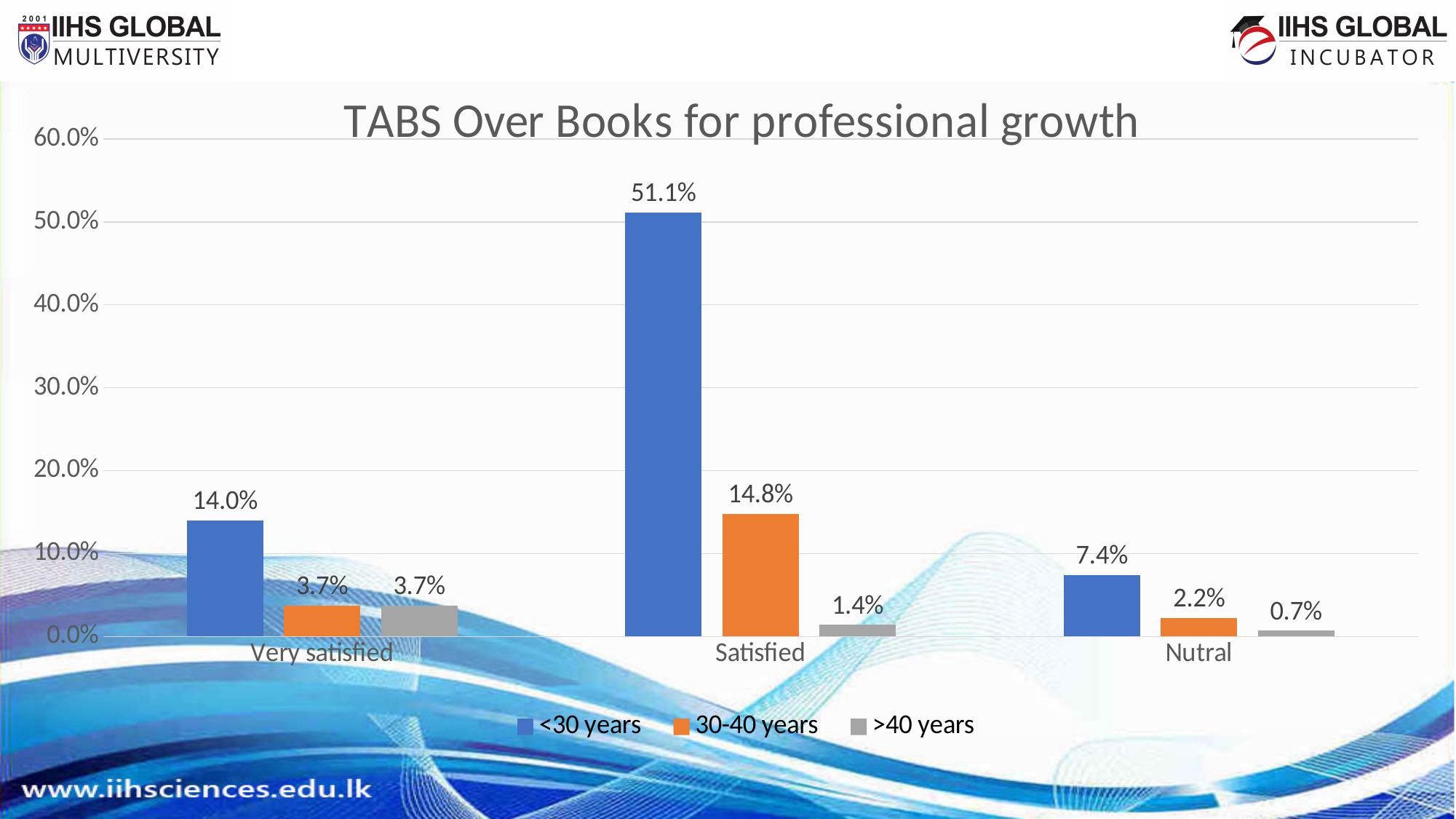
What is the title of the chart? TABS Over Books for professional growth What is the value for <30 years in the Satisfied category? 51.1% Is the value for <30 years in the Satisfied category greater or less than 50.0%? greater Which is larger in the Nutral category: the <30 years value or the 30-40 years value? <30 years Which category has the lowest value for the 30-40 years series? Nutral What is the value for 30-40 years in the Very satisfied category? 3.7% What kind of chart is shown on the slide? bar chart How many series does the legend list? 3 What is the difference between the <30 years and 30-40 years values in the Satisfied category? 36.3% Which category has the highest value for the <30 years series? Satisfied What is the value for >40 years in the Nutral category? 0.7% How many categories are shown on the x axis? 3